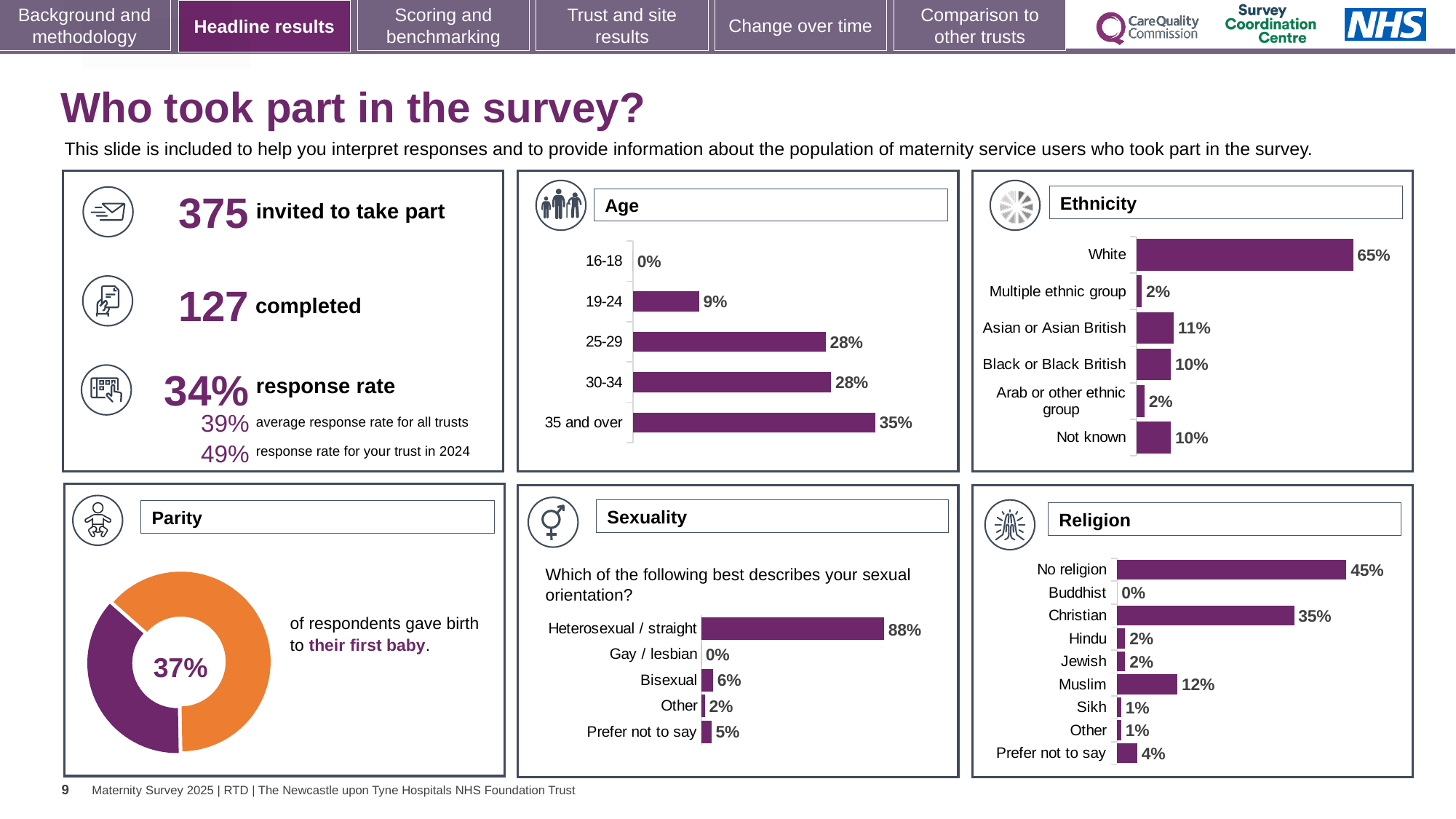
In the Parity chart, what percentage of respondents gave birth to their first baby? 37% In the Age chart, how many age categories are shown? 5 In the Sexuality chart, what percentage of respondents answered Bisexual? 6% In the Religion chart, what percentage of respondents answered Muslim? 12% In the Age chart, what percentage of respondents were aged 35 and over? 35% What kind of chart is the Parity chart? Doughnut chart In the Ethnicity chart, which is larger, Asian or Asian British or Black or Black British? Asian or Asian British In the Sexuality chart, which category has the highest value? Heterosexual / straight In the Religion chart, what is the difference between the values for No religion and Christian? 10% In the Ethnicity chart, what percentage of respondents were White? 65% In the Age chart, which age group has the lowest value? 16-18 In the Ethnicity chart, what is the difference between the values for White and Asian or Asian British? 54%